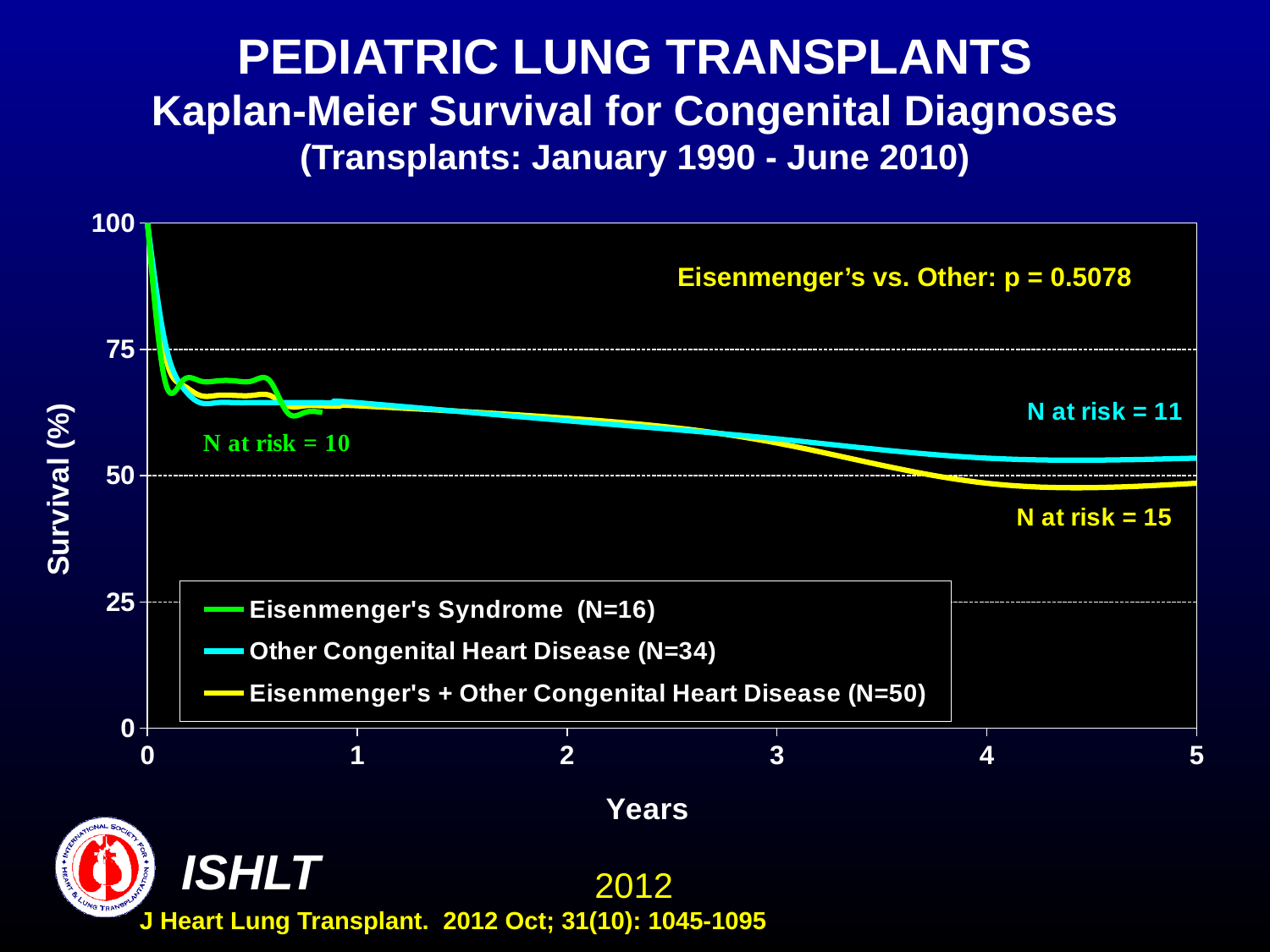
At 5 years, which curve is higher: Other Congenital Heart Disease or Eisenmenger's + Other Congenital Heart Disease? Other Congenital Heart Disease What is the p-value shown for Eisenmenger's vs. Other? p = 0.5078 How many series does the legend list? 3 Is the survival value for Other Congenital Heart Disease at 5 years greater or less than 50? greater What is the N at risk shown for the Eisenmenger's + Other Congenital Heart Disease curve? 15 What kind of chart is shown on the slide? Line chart What is the N at risk shown for the Eisenmenger's Syndrome curve? 10 How many patients (N) are in the Eisenmenger's Syndrome group according to the legend? 16 What is the N at risk shown for the Other Congenital Heart Disease curve? 11 Is the survival value for Eisenmenger's + Other Congenital Heart Disease at 5 years greater or less than 50? less How many patients (N) are in the Other Congenital Heart Disease group according to the legend? 34 Do the survival curves rise or fall as years increase? Fall